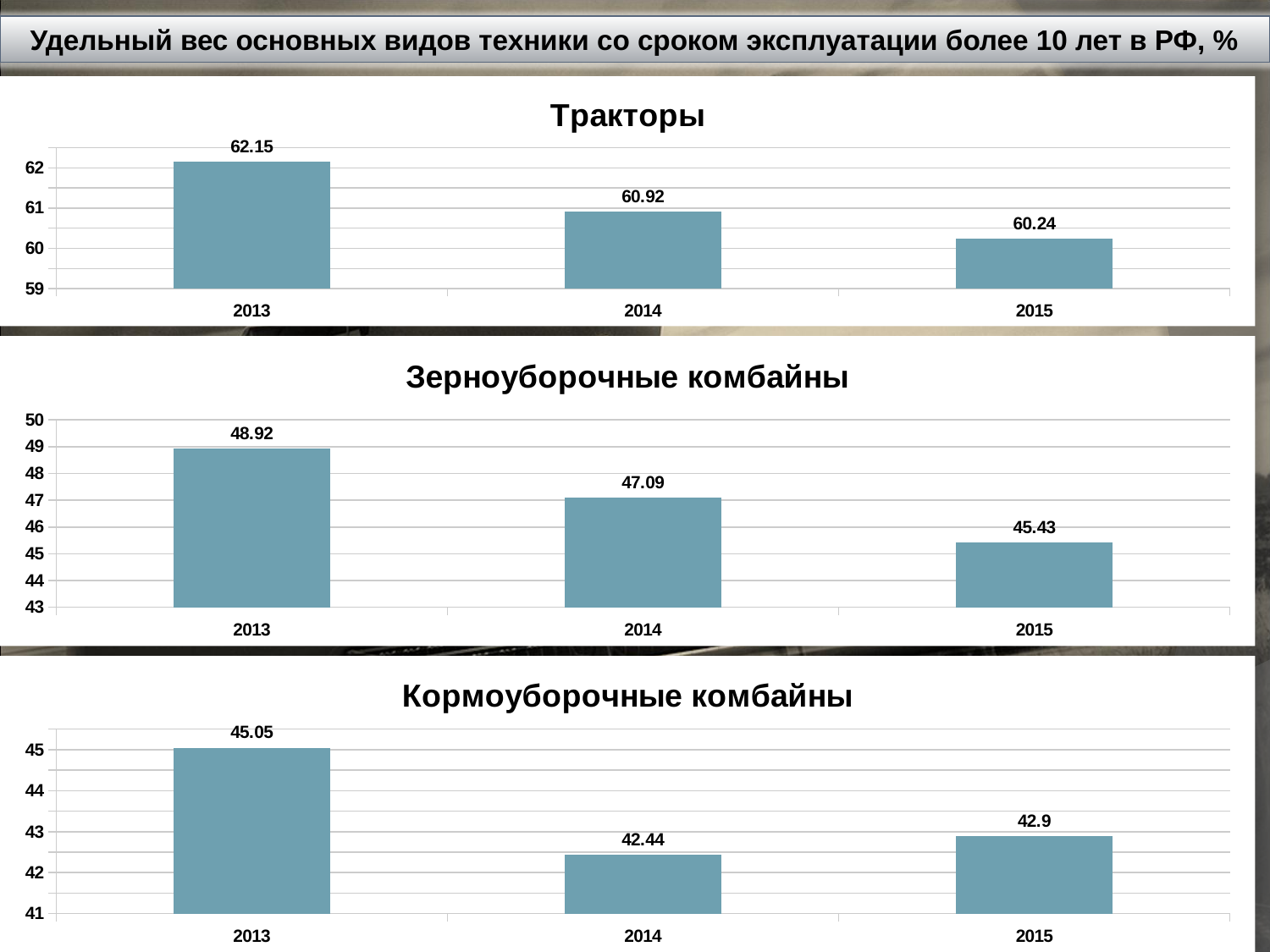
In the 'Зерноуборочные комбайны' chart, what is the value for 2014? 47.09 In the 'Тракторы' chart, what is the value for 2013? 62.15 In the 'Зерноуборочные комбайны' chart, do the values rise or fall from 2013 to 2015? fall In the 'Тракторы' chart, what is the difference between the 2013 and 2015 values? 1.91 In the 'Кормоуборочные комбайны' chart, which is larger, the value for 2013 or the value for 2015? 2013 In the 'Зерноуборочные комбайны' chart, which year has the highest value? 2013 In the 'Кормоуборочные комбайны' chart, what is the difference between the 2013 and 2014 values? 2.61 In the 'Кормоуборочные комбайны' chart, what is the value for 2015? 42.9 How many years are shown in the 'Тракторы' chart? 3 What type of chart is the 'Зерноуборочные комбайны' chart? bar chart In the 'Кормоуборочные комбайны' chart, which year has the lowest value? 2014 In the 'Тракторы' chart, which year has the lowest value? 2015